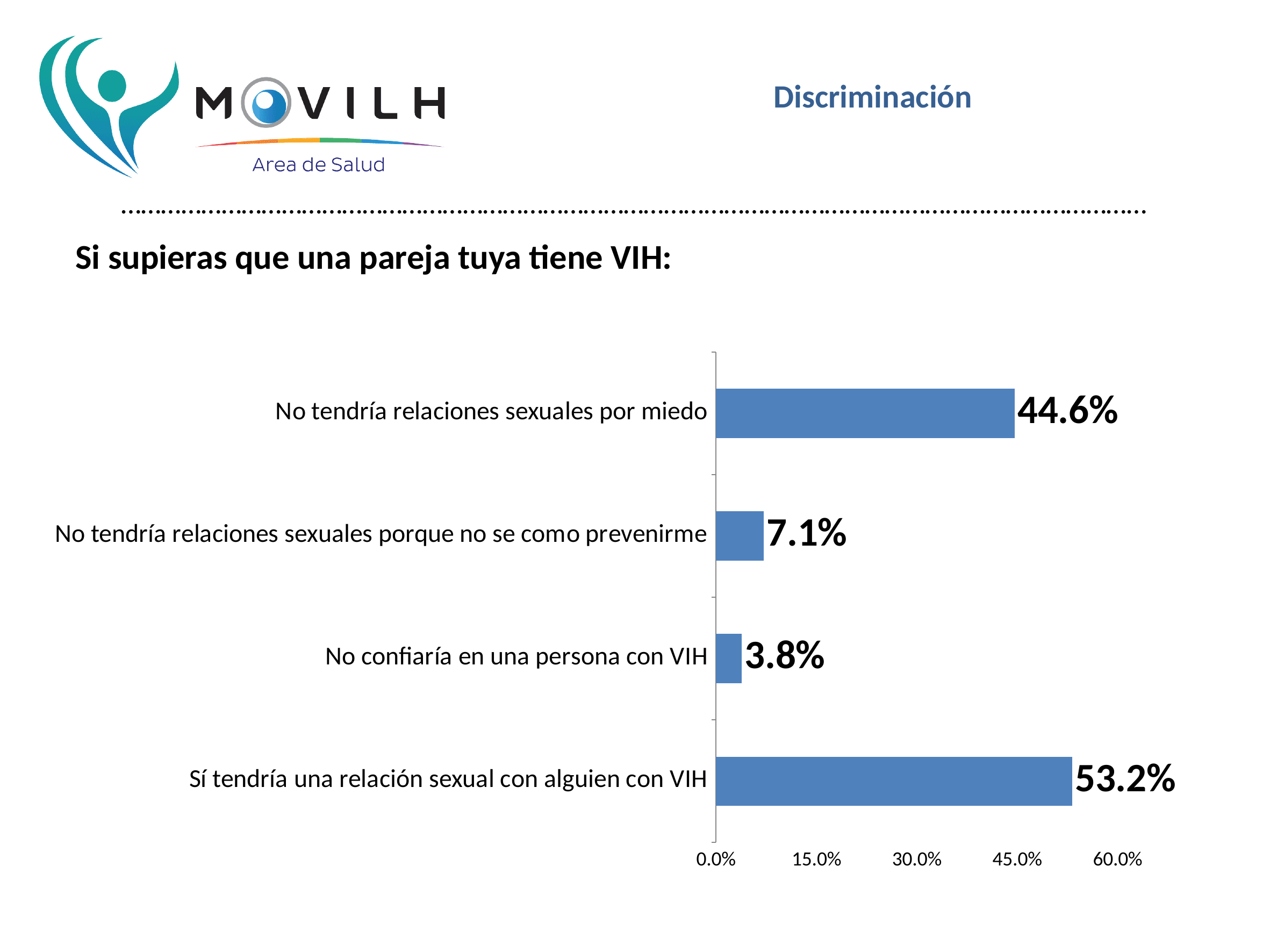
How many categories does the chart show? 4 What is the value for "Sí tendría una relación sexual con alguien con VIH"? 53.2% Which category has the lowest value? No confiaría en una persona con VIH What is the difference between the values for "Sí tendría una relación sexual con alguien con VIH" and "No tendría relaciones sexuales por miedo"? 8.6% Which category has the highest value? Sí tendría una relación sexual con alguien con VIH What is the value for "No tendría relaciones sexuales por miedo"? 44.6% Which is larger: the value for "No tendría relaciones sexuales por miedo" or for "No tendría relaciones sexuales porque no se como prevenirme"? No tendría relaciones sexuales por miedo What is the value for "No confiaría en una persona con VIH"? 3.8% What kind of chart is shown on the slide? bar chart What is the value for "No tendría relaciones sexuales porque no se como prevenirme"? 7.1% Is the value for "No tendría relaciones sexuales por miedo" greater or less than 30.0%? greater What is the difference between the values for "No tendría relaciones sexuales porque no se como prevenirme" and "No confiaría en una persona con VIH"? 3.3%